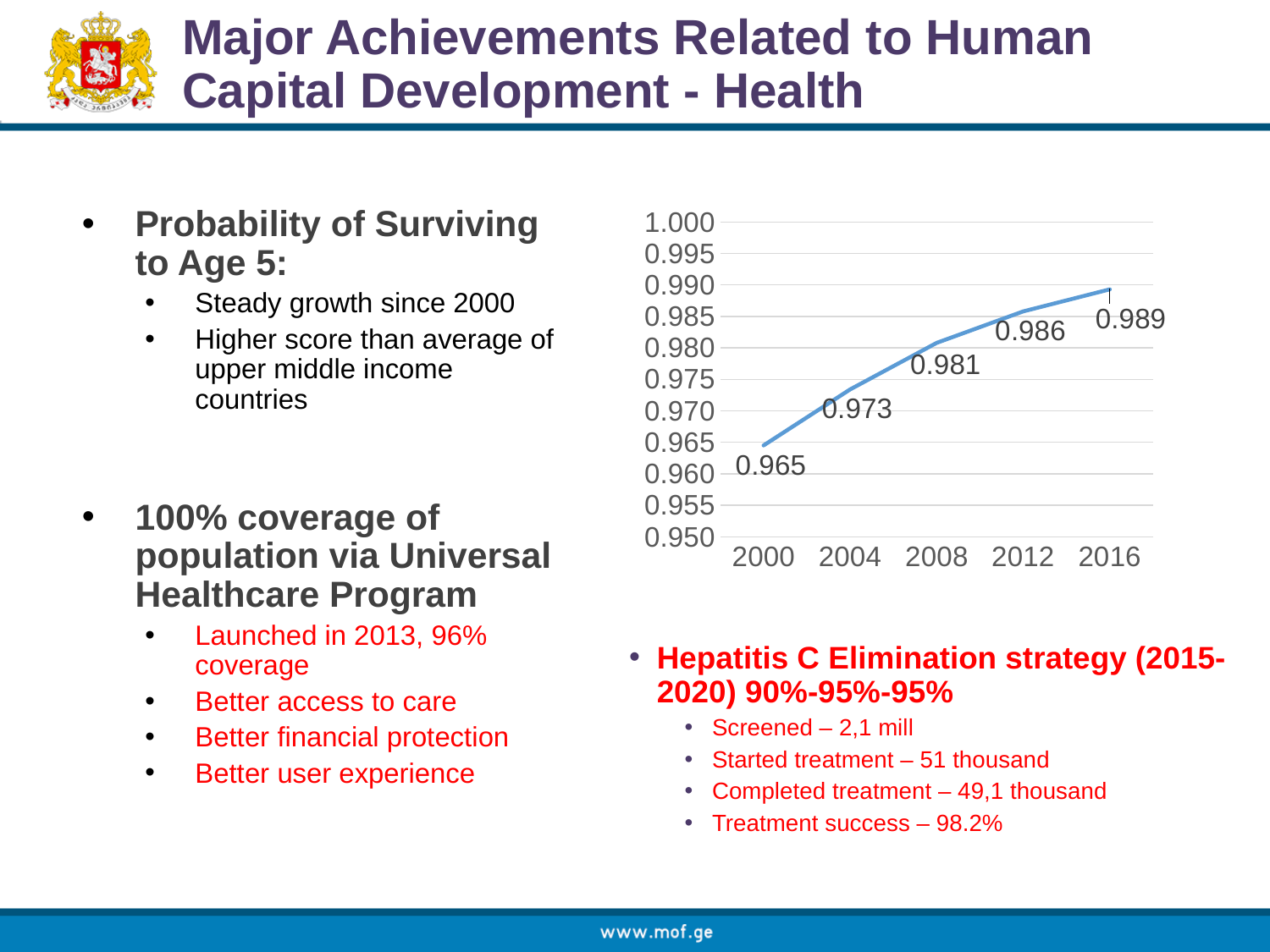
Which year has the highest value on the chart? 2016 Which is larger, the value for 2004 or the value for 2008? 2008 What is the value plotted for 2000? 0.965 Which year has the lowest value on the chart? 2000 What is the value plotted for 2008? 0.981 How many data points are plotted on the chart? 5 What is the value plotted for 2012? 0.986 What kind of chart is shown on the slide? line chart Is the value for 2004 greater or less than 0.970? greater Do the values rise or fall from 2000 to 2016? rise What is the difference between the values for 2016 and 2000? 0.024 What is the value plotted for 2016? 0.989